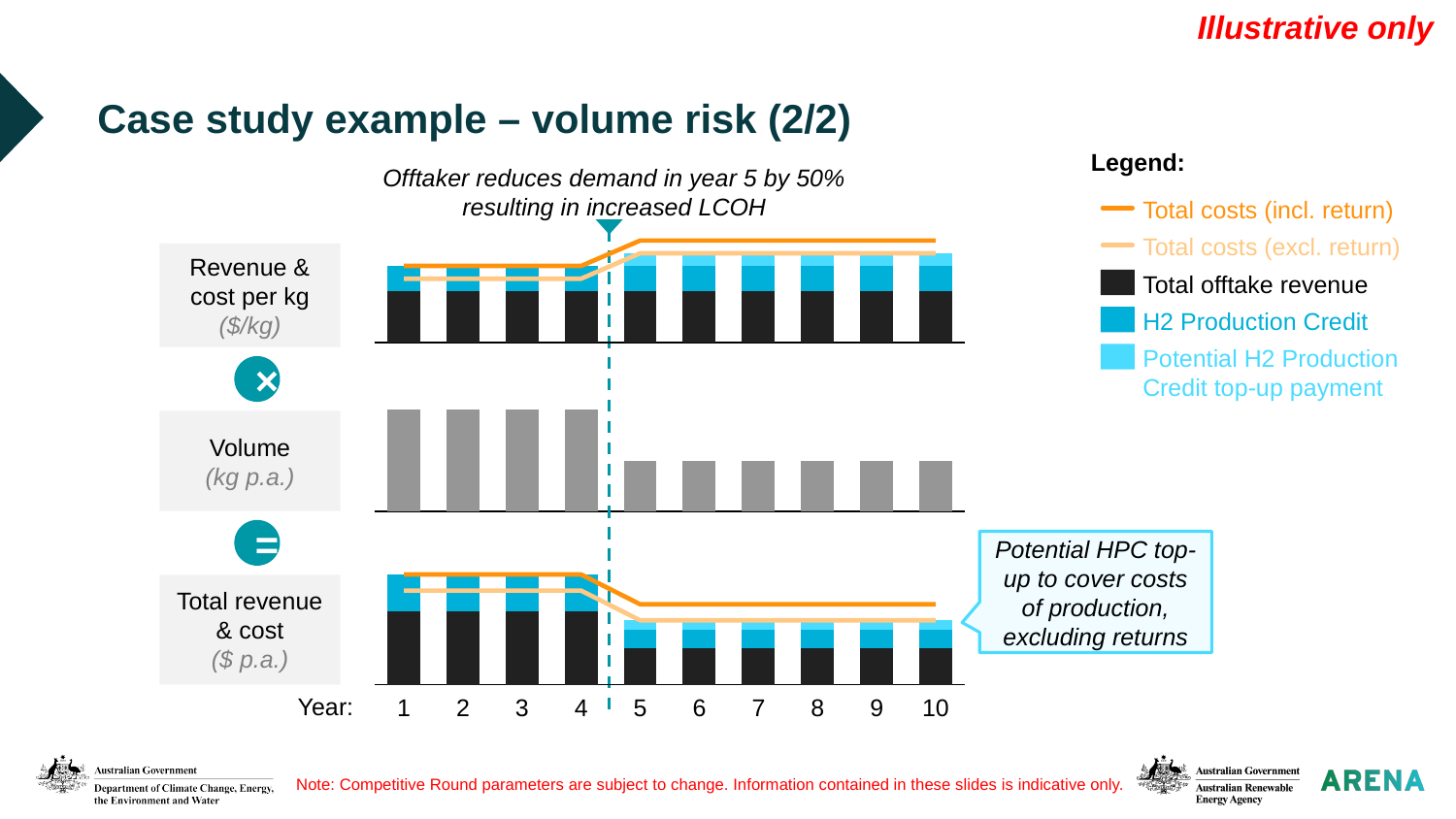
In the Total revenue & cost ($ p.a.) chart, does the Total costs (incl. return) line rise or fall between year 4 and year 5? Fall In which year does the offtaker reduce demand by 50%, according to the annotation above the charts? Year 5 In the Revenue & cost per kg ($/kg) chart, does the Total costs (incl. return) line rise or fall between year 4 and year 5? Rise How many years are shown along the x axis of the charts? 10 In the Total revenue & cost ($ p.a.) chart, is the Total offtake revenue bar for year 2 taller or shorter than the one for year 8? Taller How many entries does the legend list? 5 In the Volume (kg p.a.) chart, do the bars rise or fall between year 4 and year 5? Fall Which legend entry is shown in black? Total offtake revenue In the Revenue & cost per kg ($/kg) chart, in which year does the Potential H2 Production Credit top-up payment segment first appear? Year 5 In the Volume (kg p.a.) chart, is the bar for year 3 taller or shorter than the bar for year 7? Taller What kind of chart is the Volume (kg p.a.) chart? Bar chart In the Volume (kg p.a.) chart, how many years have the taller bars before the demand reduction? 4